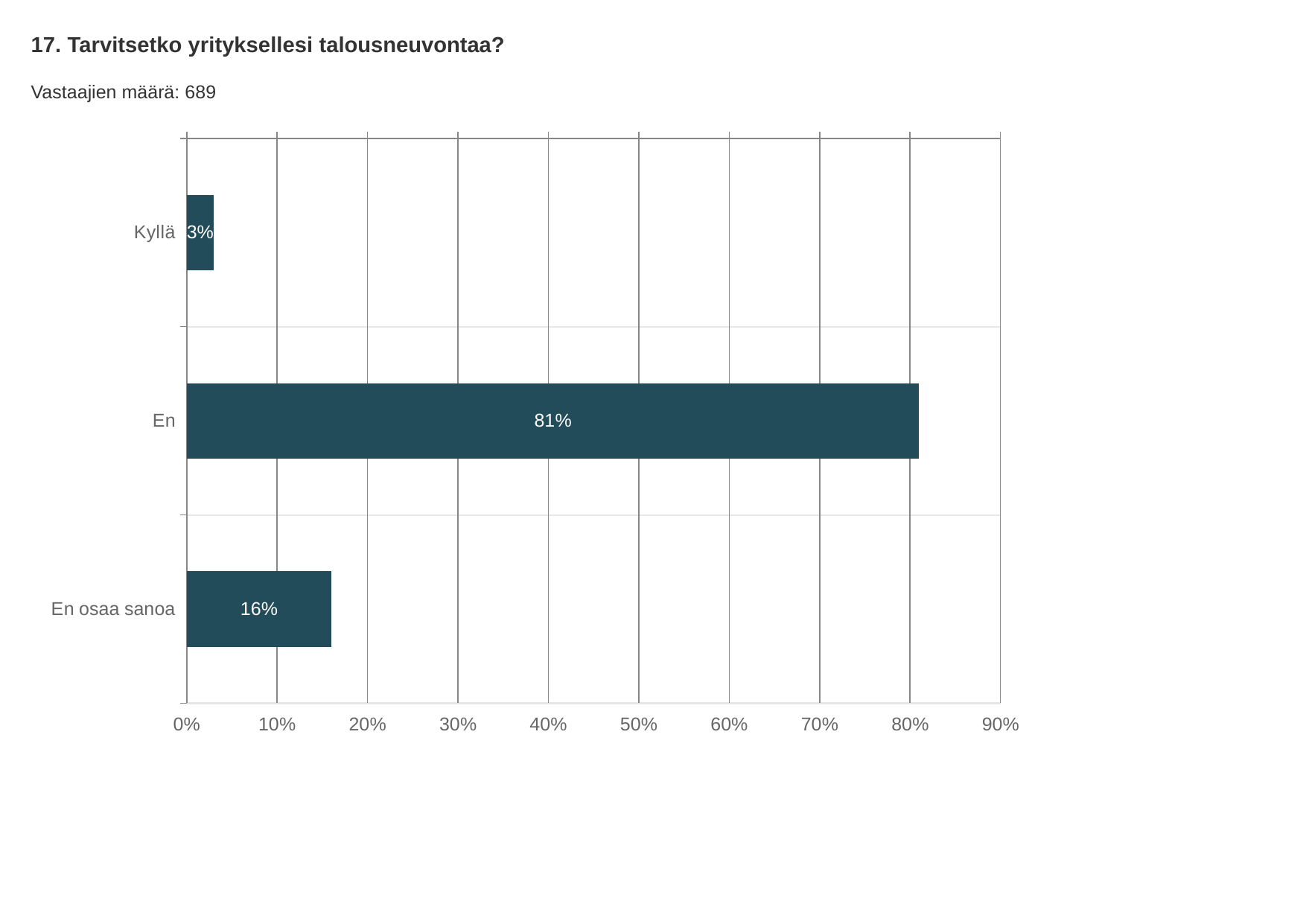
How many respondents (Vastaajien määrä) are reported on the slide? 689 What is the value for En? 81% Which category has the lowest value? Kyllä Which category has the highest value? En What is the difference between the values for En and En osaa sanoa? 65% Which is larger, the value for Kyllä or the value for En osaa sanoa? En osaa sanoa What is the value for Kyllä? 3% What kind of chart is shown on the slide? bar chart Is the value for En greater or less than 70%? greater How many categories are shown in the chart? 3 What is the value for En osaa sanoa? 16% What is the difference between the values for En osaa sanoa and Kyllä? 13%